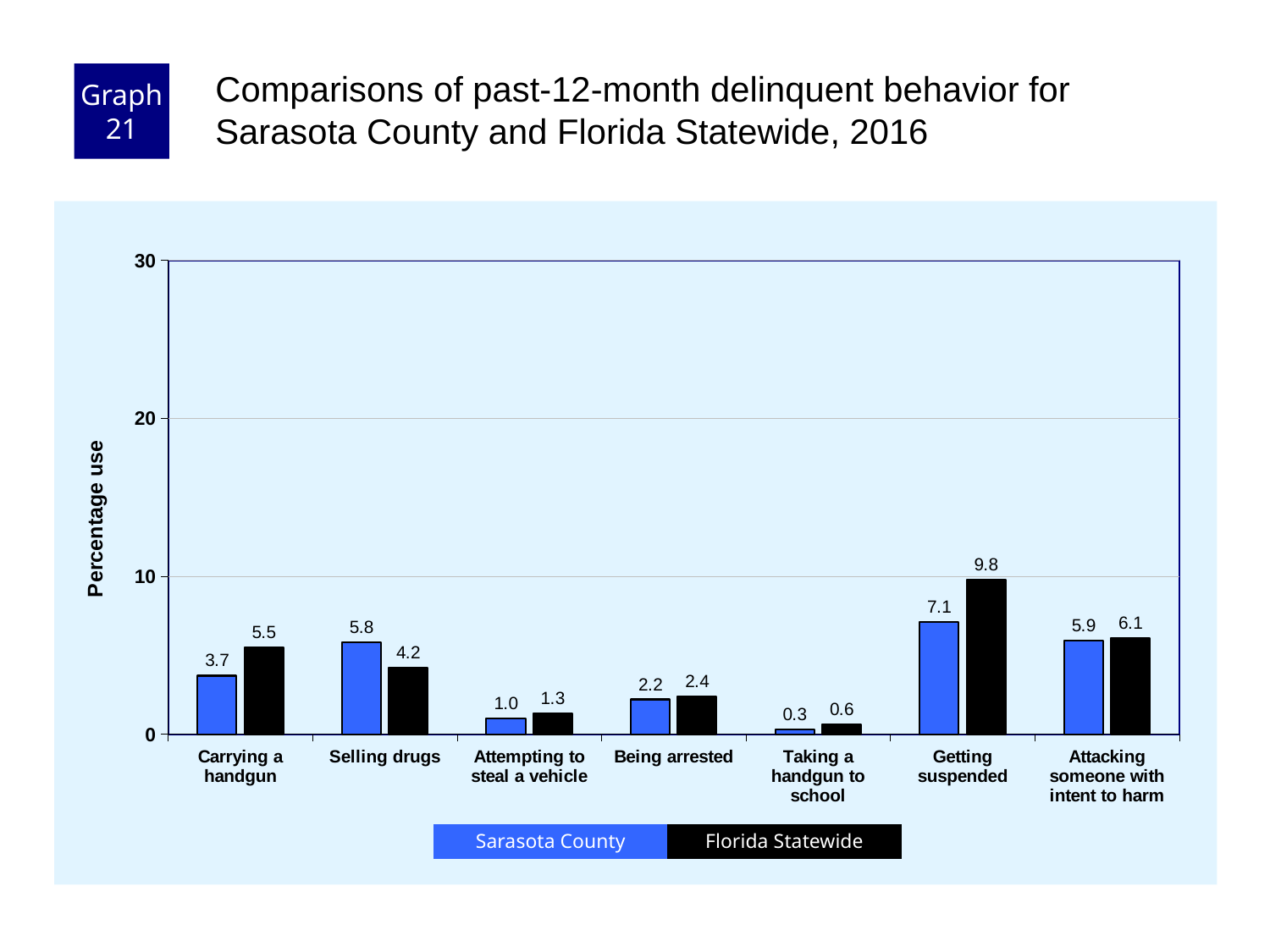
What is the Sarasota County value for Taking a handgun to school? 0.3 What is the difference between the Florida Statewide and Sarasota County values for Getting suspended? 2.7 Which category has the highest Florida Statewide value? Getting suspended How many series does the legend list? 2 How many categories are shown on the x axis? 7 What is the Florida Statewide value for Carrying a handgun? 5.5 Which is larger for Selling drugs: the Sarasota County value or the Florida Statewide value? Sarasota County Is the Florida Statewide value for Getting suspended greater or less than 10? less What is the label of the y axis? Percentage use Which category has the lowest Sarasota County value? Taking a handgun to school What is the Sarasota County value for Getting suspended? 7.1 What kind of chart is shown on the slide? bar chart